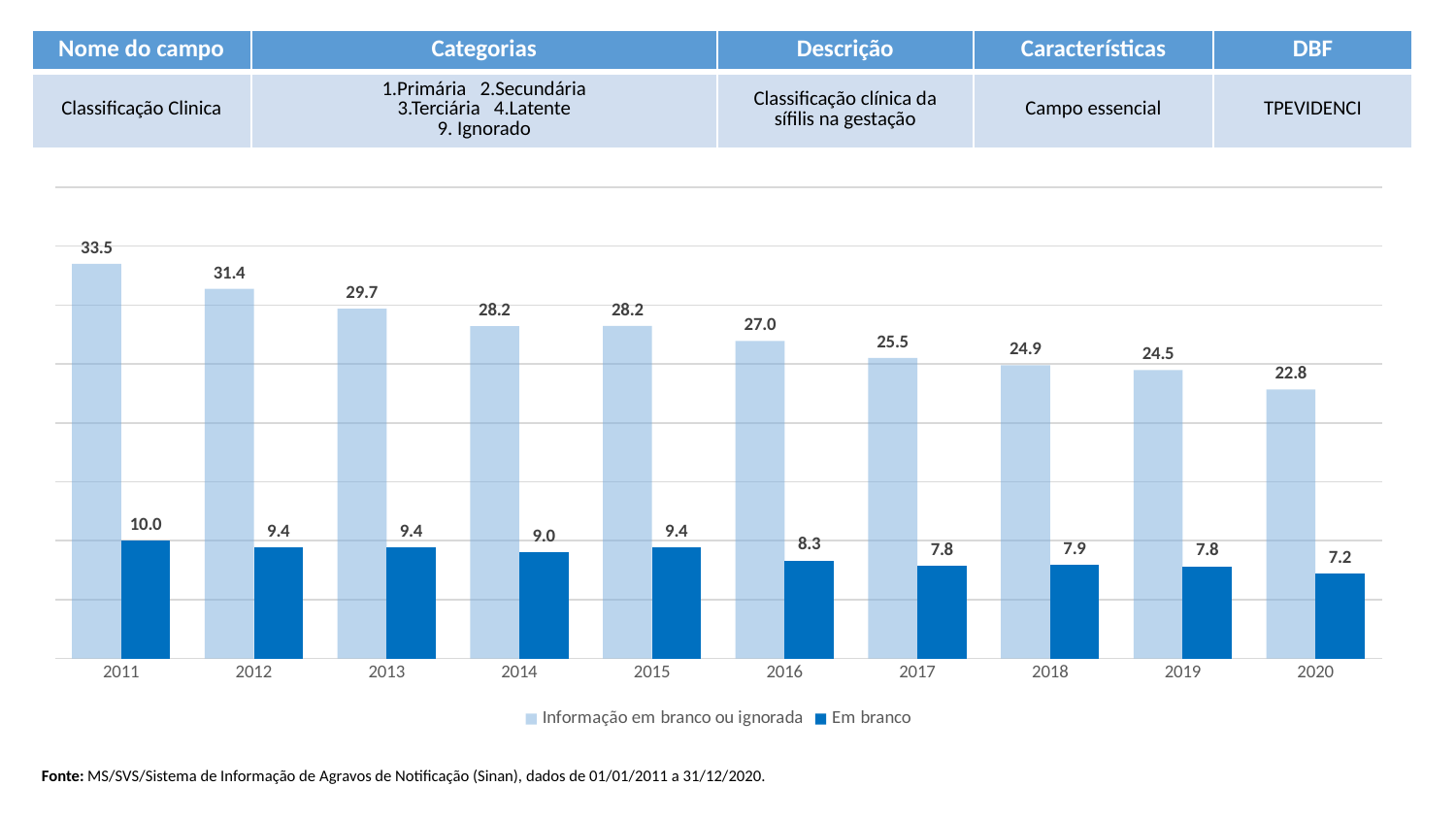
What is the value for "Em branco" in 2016? 8.3 Do the "Informação em branco ou ignorada" values generally rise or fall from 2011 to 2020? Fall What is the value for "Informação em branco ou ignorada" in 2011? 33.5 What is the difference between the "Informação em branco ou ignorada" values for 2011 and 2020? 10.7 Which year has the highest value for "Informação em branco ou ignorada"? 2011 What kind of chart is shown on the slide? Bar chart What is the value for "Em branco" in 2020? 7.2 How many series does the legend list? 2 Which is larger: the "Informação em branco ou ignorada" value for 2013 or for 2017? 2013 How many years are shown on the x axis? 10 What is the difference between the "Em branco" values for 2011 and 2012? 0.6 Which year has the lowest value for "Em branco"? 2020